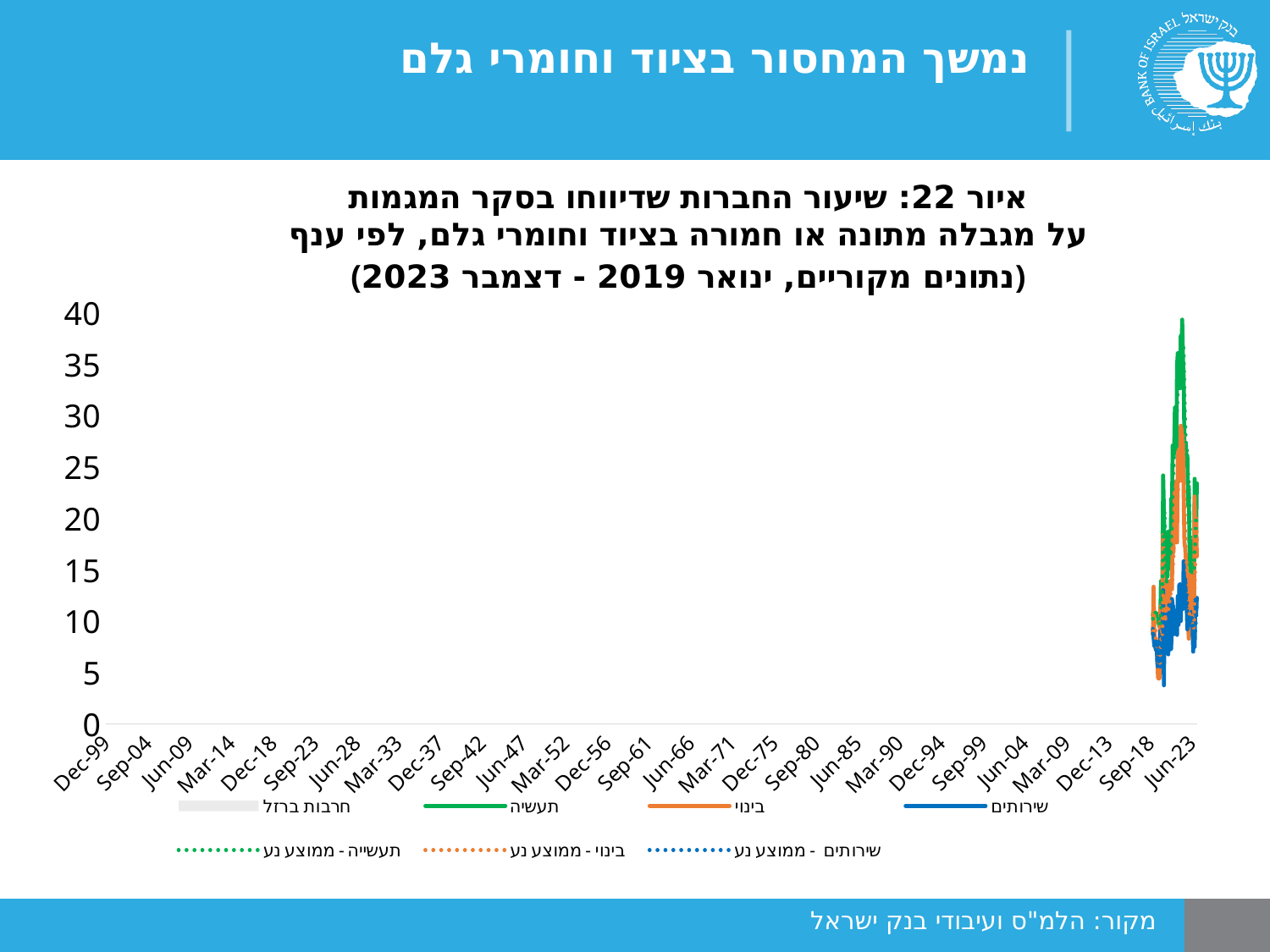
What is the last label shown on the chart's x-axis? Jun-23 What is the figure number given in the chart title? 22 Which series reaches the highest peak on the chart? תעשיה Is the peak value of the תעשיה series greater or less than 35? greater What is the first label shown on the chart's x-axis? Dec-99 Is the peak value of the שירותים series greater or less than 20? less What kind of chart is shown on the slide? line chart How many series does the chart's legend list? 7 What is the highest value shown on the chart's y-axis? 40 Which of the three solid-line series (תעשיה, בינוי, שירותים) stays lowest on the chart? שירותים Which series peaks higher, תעשיה or שירותים? תעשיה Is the peak value of the בינוי series greater or less than 25? greater